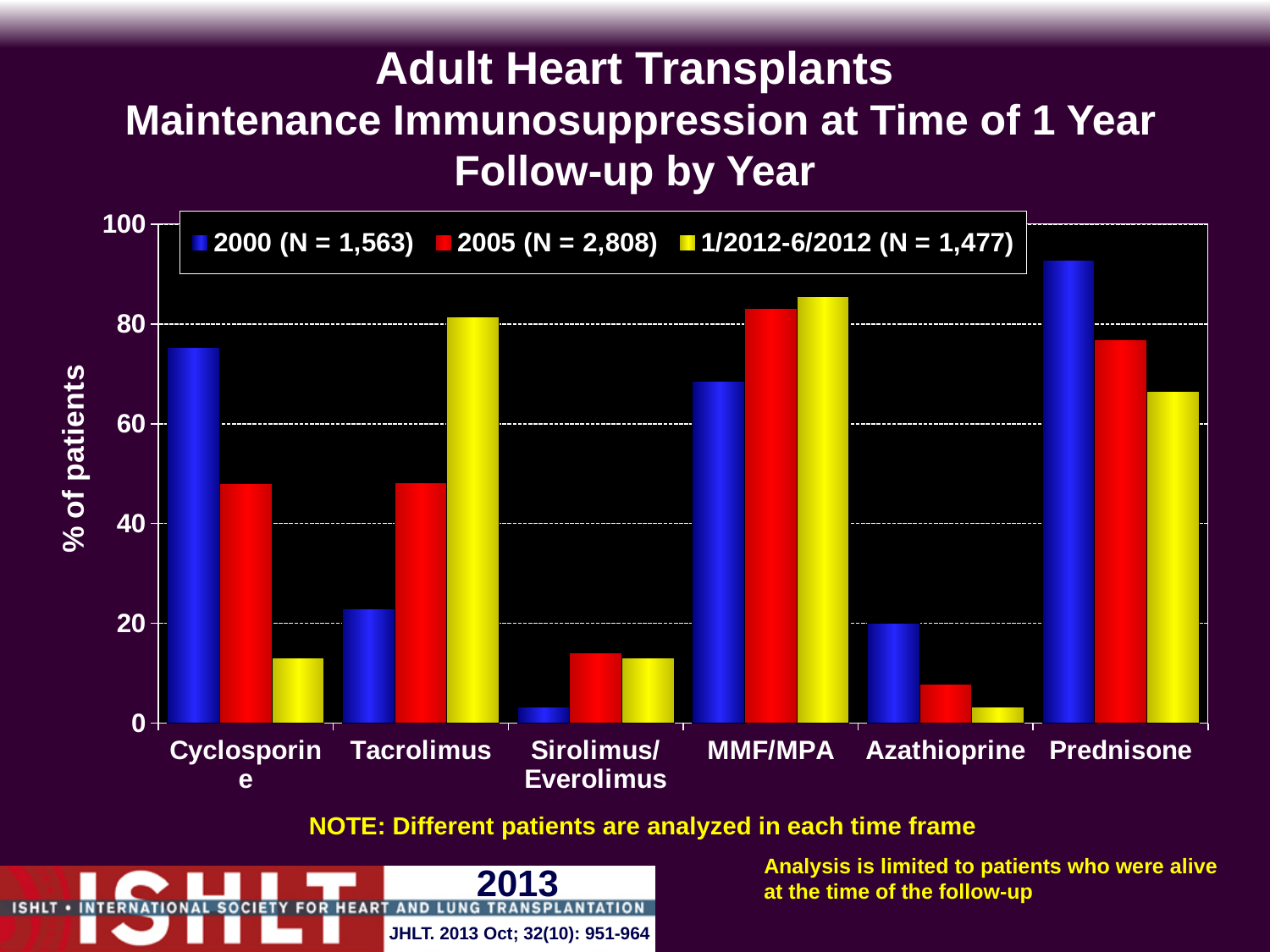
Is the value for Azathioprine in 1/2012-6/2012 greater or less than 20? less How many series does the legend list? 3 Which drug category has the lowest value for the 2000 series? Sirolimus/Everolimus Does the value for Cyclosporine rise or fall from 2000 to 2005 to 1/2012-6/2012? fall Which drug category has the highest value for the 2000 series? Prednisone What is the N shown in the legend for the 2005 series? 2,808 Is the value for Tacrolimus in 1/2012-6/2012 greater or less than 60? greater How many drug categories are shown on the x axis? 6 Is the value for Cyclosporine in 2000 greater or less than 60? greater For Cyclosporine, which is larger: the 2000 value or the 1/2012-6/2012 value? 2000 What kind of chart is shown on the slide? bar chart For Tacrolimus, which is larger: the 2000 value or the 1/2012-6/2012 value? 1/2012-6/2012